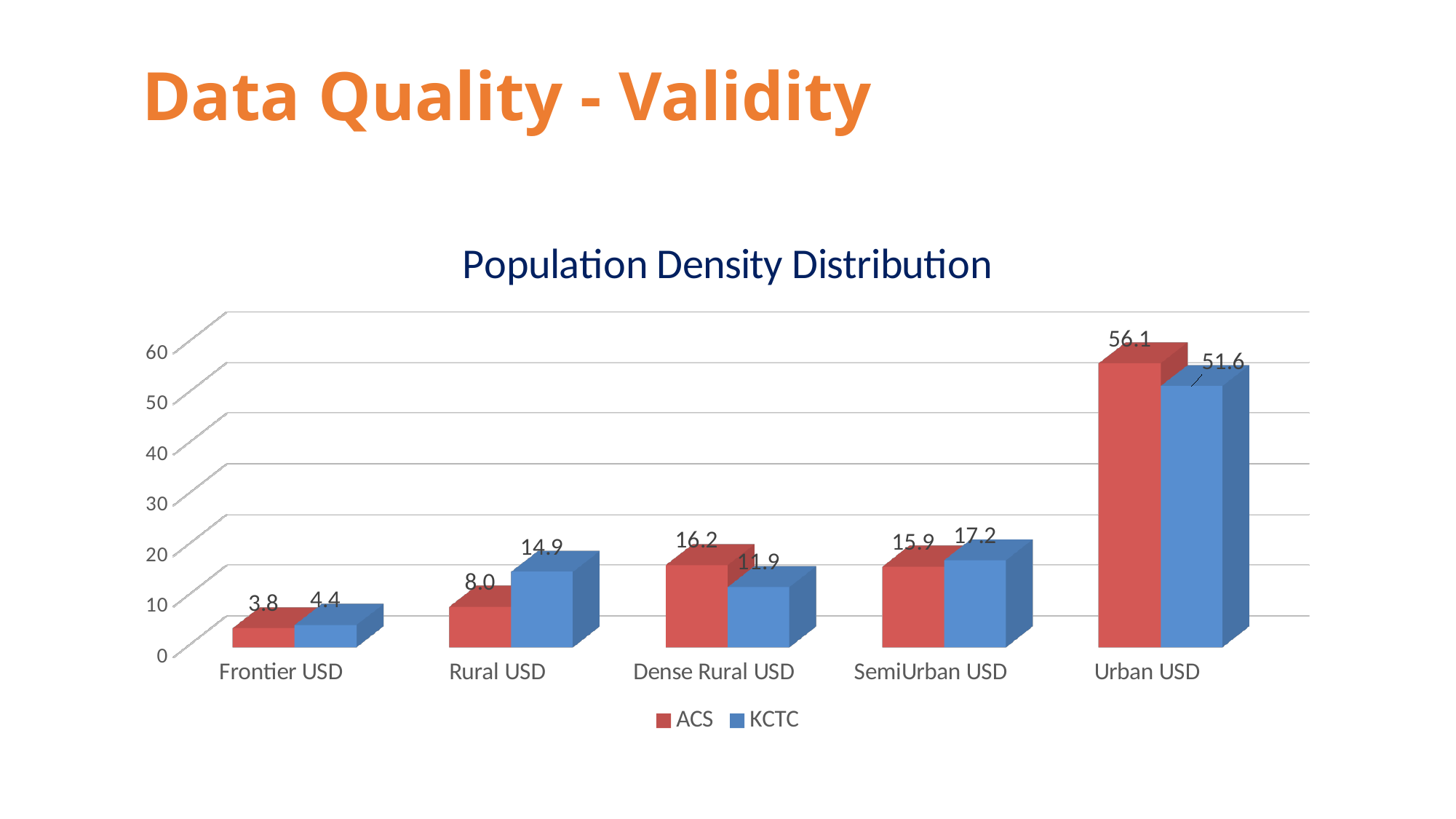
How many categories are shown on the x axis? 5 Which category has the lowest ACS value? Frontier USD What is the KCTC value for Dense Rural USD? 11.9 What kind of chart is shown on the slide? Bar chart How many series does the legend list? 2 What is the KCTC value for Rural USD? 14.9 What is the difference between the KCTC and ACS values for Rural USD? 6.9 What is the ACS value for Frontier USD? 3.8 What is the difference between the ACS and KCTC values for Urban USD? 4.5 What is the ACS value for Urban USD? 56.1 Which category has the highest KCTC value? Urban USD For Dense Rural USD, which series has the larger value, ACS or KCTC? ACS